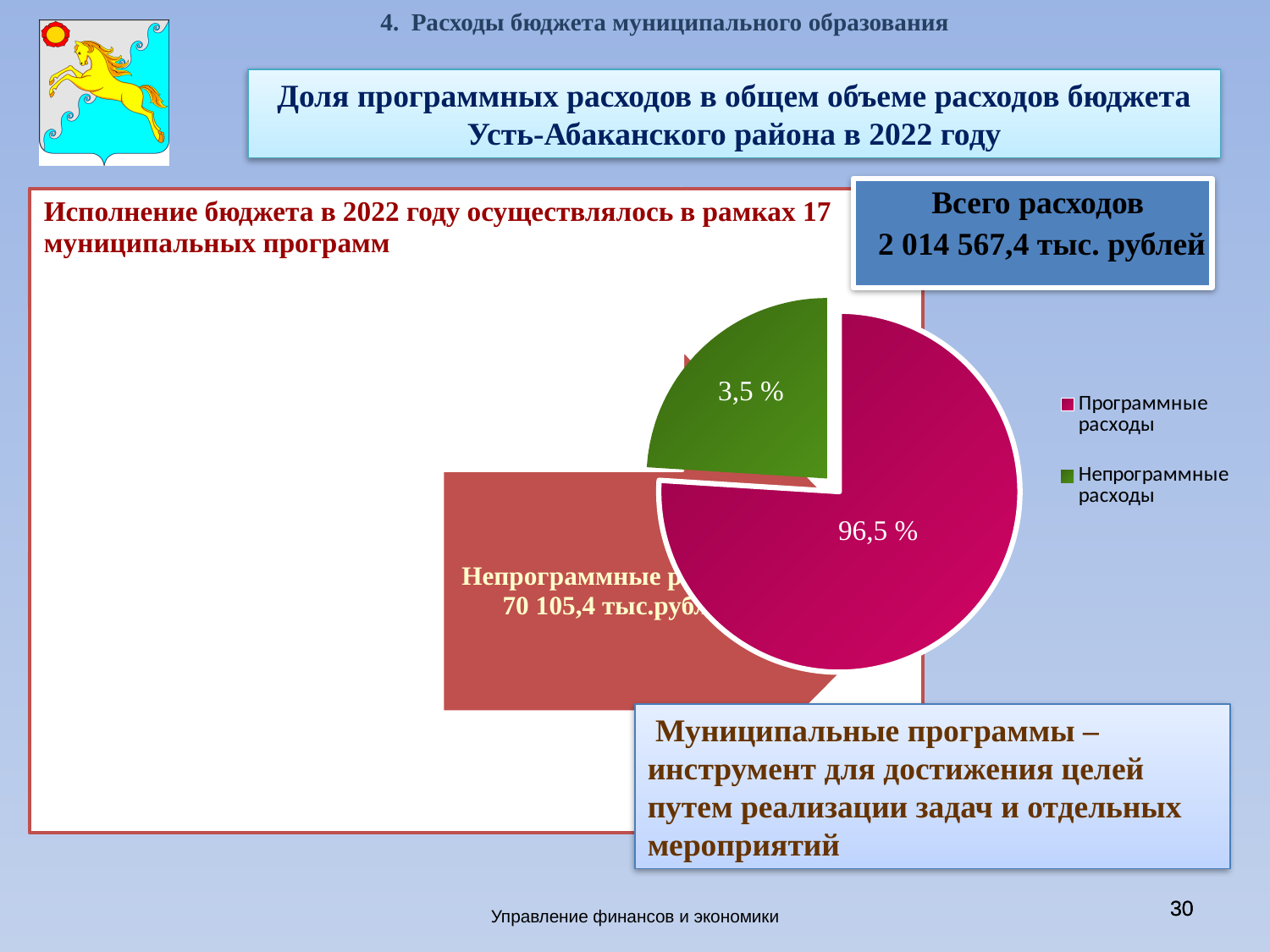
What colour is the "Программные расходы" slice in the pie chart? magenta Which slice of the pie chart is the smallest? Непрограммные расходы Which is larger: the share of "Программные расходы" or the share of "Непрограммные расходы"? Программные расходы According to the slide, what is the total amount of expenses ("Всего расходов")? 2 014 567,4 тыс. рублей How many entries does the legend of the pie chart list? 2 What colour is the "Непрограммные расходы" slice in the pie chart? green What share of the pie does "Непрограммные расходы" take? 3,5 % How many slices does the pie chart have? 2 What is the difference in percentage points between the "Программные расходы" and "Непрограммные расходы" slices? 93 percentage points What share of the pie does "Программные расходы" take? 96,5 % What kind of chart is shown on the slide? pie chart Which slice of the pie chart is the largest? Программные расходы